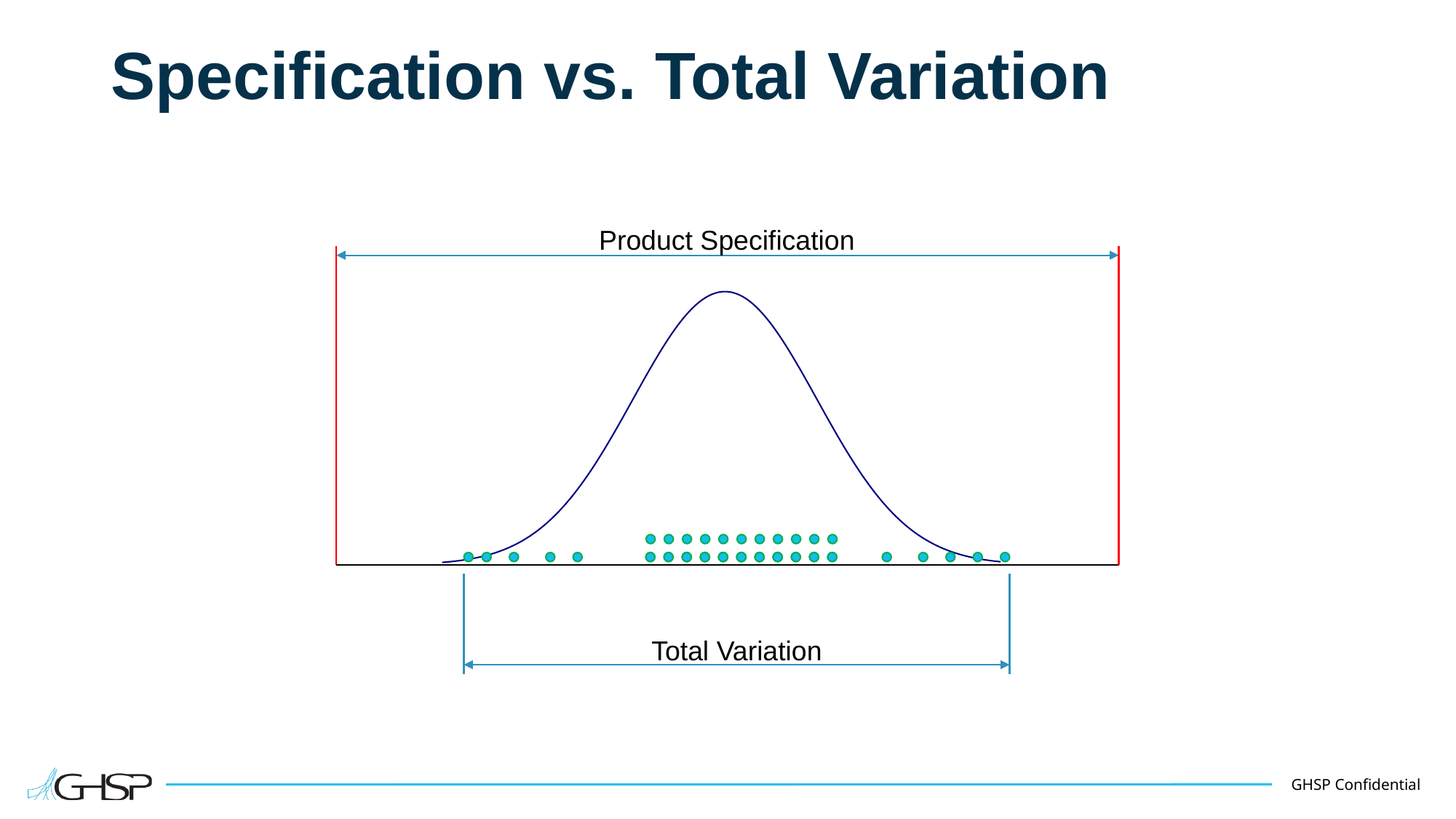
What is the title of the slide containing the chart? Specification vs. Total Variation What is the label on the arrow above the curve? Product Specification Does the Total Variation span fall entirely inside the Product Specification limits? Yes What is the label on the arrow below the curve? Total Variation Which span is wider on the chart, Product Specification or Total Variation? Product Specification What kind of chart is shown on the slide? A bell curve (normal distribution curve) with data points